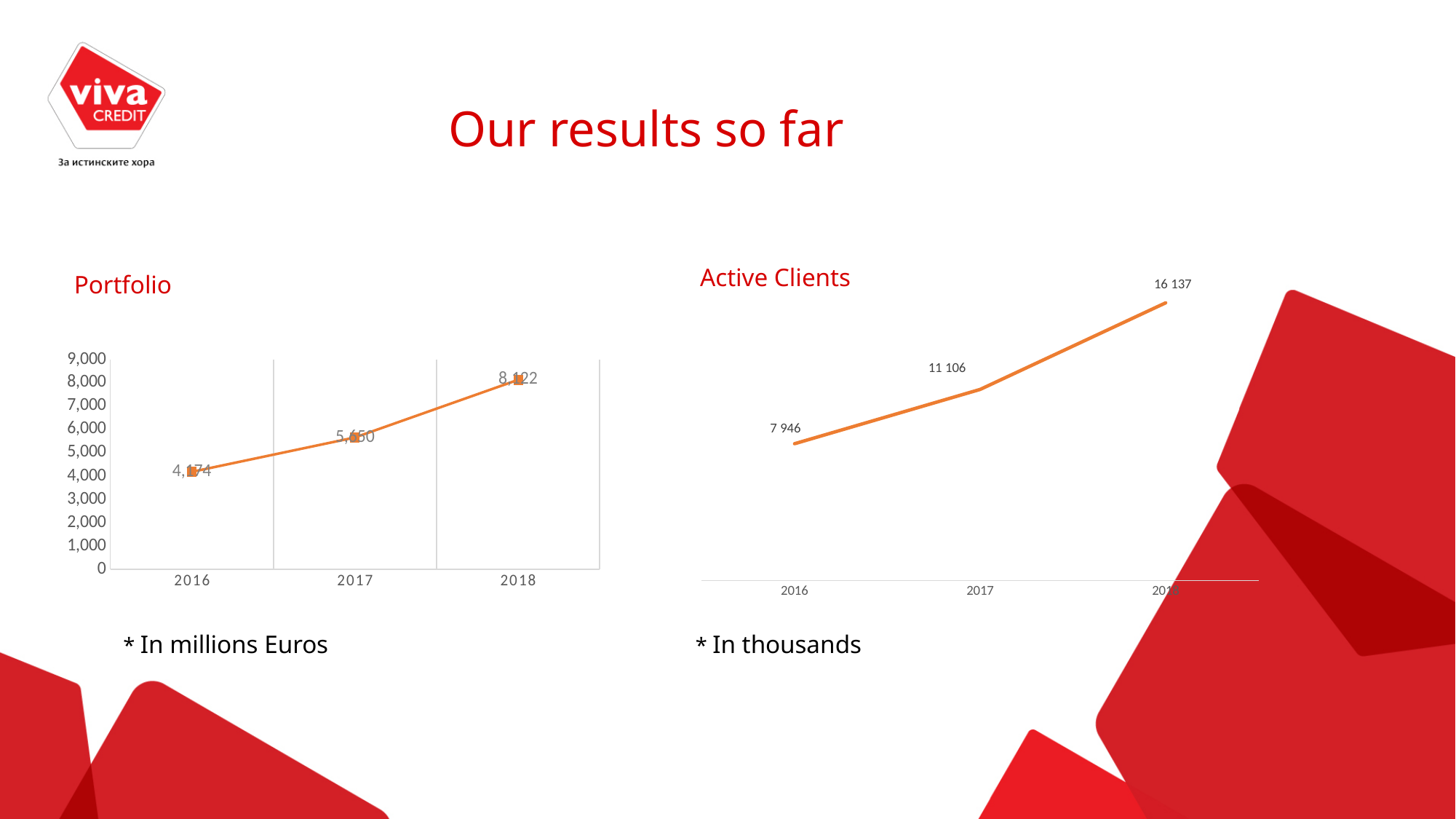
On the Active Clients chart, what is the value for 2018? 16 137 On the Active Clients chart, which year has the highest value? 2018 On the Active Clients chart, which year has the lowest value? 2016 On the Portfolio chart, is the value for 2018 greater or less than 9,000? less On the Portfolio chart, is the value for 2016 greater or less than 5,000? less What kind of chart is the Portfolio chart? line chart On the Active Clients chart, what is the difference between the 2017 and 2016 values? 3 160 On the Active Clients chart, what is the difference between the 2018 and 2016 values? 8 191 On the Portfolio chart, do the values rise or fall from 2016 to 2018? rise On the Active Clients chart, what is the value for 2017? 11 106 On the Active Clients chart, what is the value for 2016? 7 946 On the Portfolio chart, is the value for 2017 greater or less than 5,000? greater